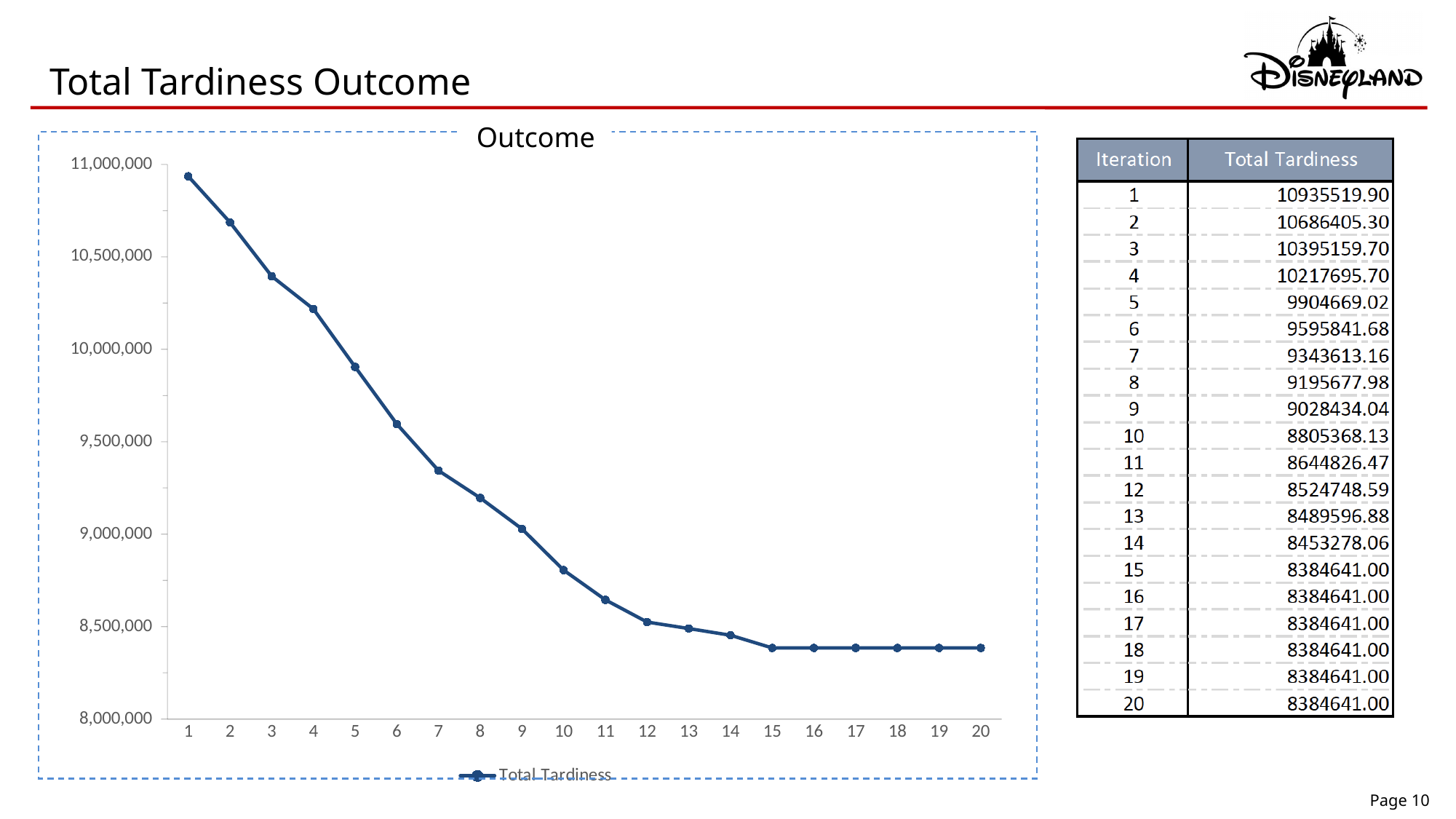
How many series does the chart legend list? 1 What kind of chart is shown on the slide? line chart Is the Total Tardiness at iteration 5 greater or less than 10,000,000? less What is the Total Tardiness at iteration 20? 8384641.00 Which iteration has the highest Total Tardiness? 1 Does Total Tardiness rise or fall from iteration 1 to iteration 15? fall What is the Total Tardiness at iteration 1? 10935519.90 What is the Total Tardiness at iteration 10? 8805368.13 What is the difference between the Total Tardiness at iteration 15 and at iteration 20? 0.00 Which is larger, the Total Tardiness at iteration 3 or at iteration 8? iteration 3 What is the title of the chart? Outcome How many iterations are plotted on the x axis of the chart? 20